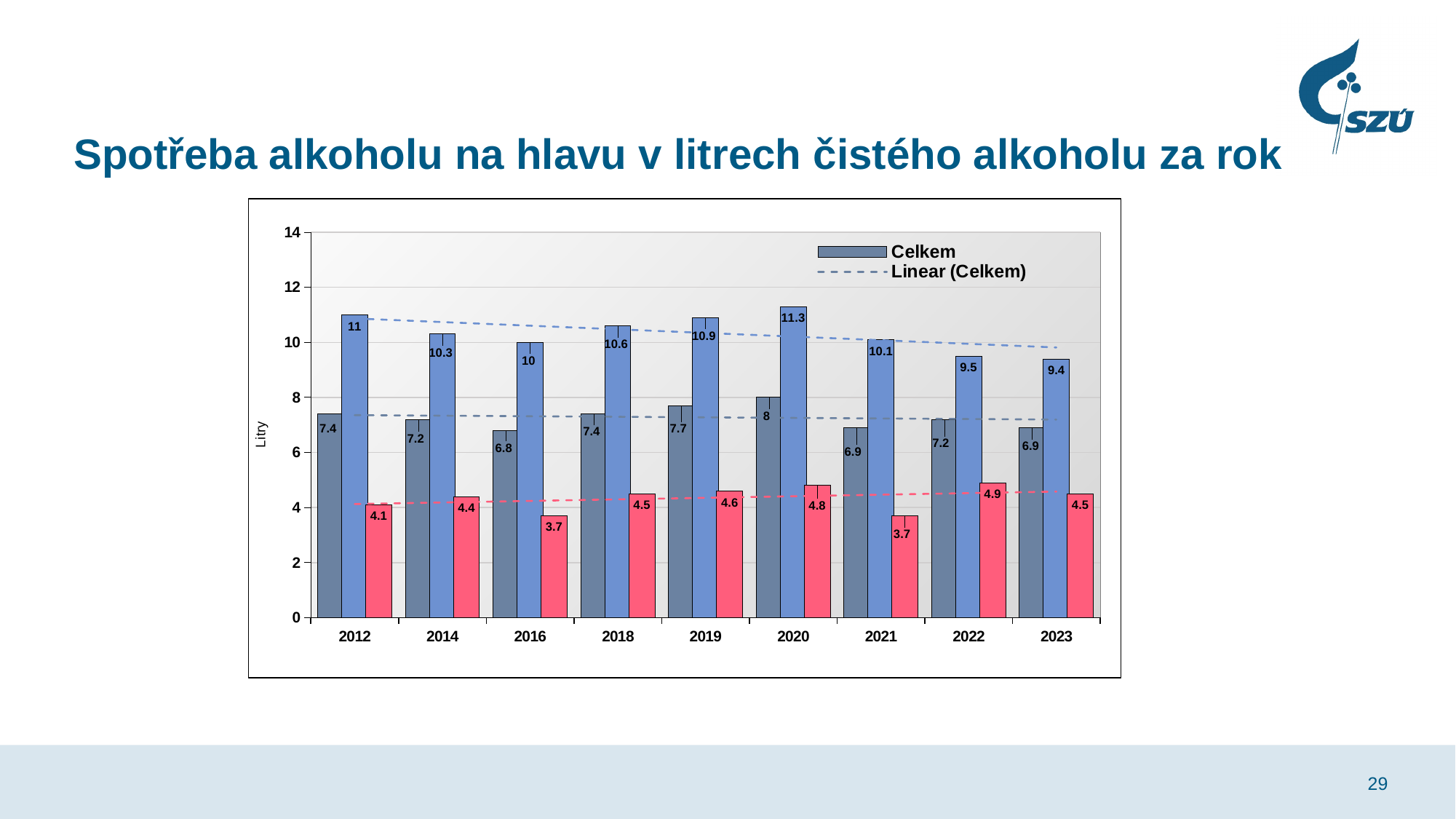
What is the Celkem value for 2016? 6.8 How many years are shown on the x axis? 9 Which year has the larger Celkem value, 2019 or 2021? 2019 How many entries does the legend list? 2 What is the value of the pink bar for 2022? 4.9 In which year is the Celkem value highest? 2020 What is the Celkem value for 2020? 8 What is the Celkem value for 2023? 6.9 In which year is the Celkem value lowest? 2016 What is the label of the y axis? Litry What kind of chart is shown on the slide? bar chart What is the difference between the Celkem values for 2020 and 2016? 1.2